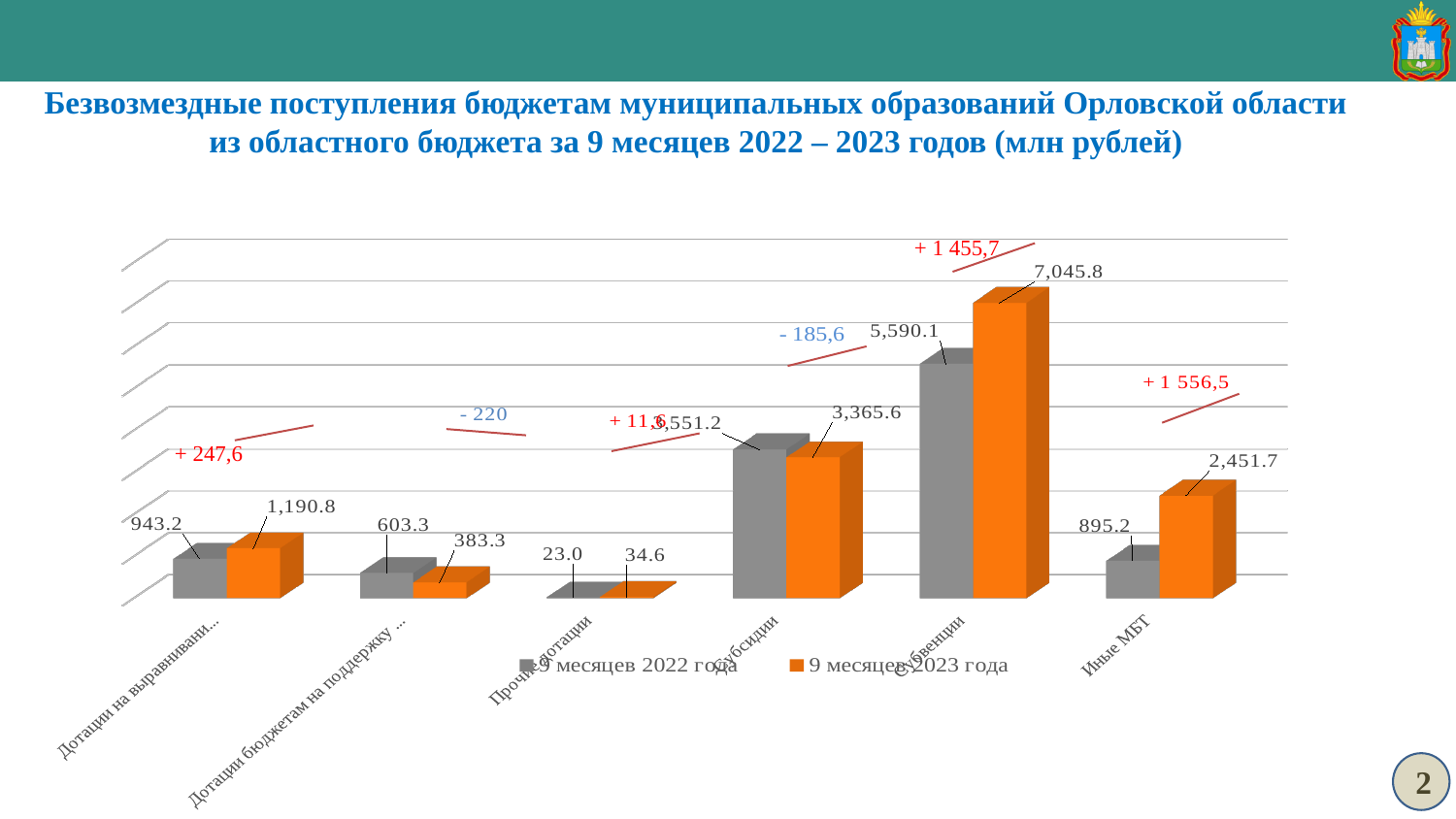
What is the value for Прочие дотации in the 9 месяцев 2023 года series? 34.6 What kind of chart is shown on the slide? Bar chart Which category has the highest value in the 9 месяцев 2023 года series? Субвенции How many categories are shown on the x axis of the chart? 6 What is the value for Иные МБТ in the 9 месяцев 2022 года series? 895.2 Which category has the lowest value in the 9 месяцев 2022 года series? Прочие дотации By how much does the 9 месяцев 2023 года value for Субвенции exceed the 9 месяцев 2022 года value? 1,455.7 For Субсидии, which series has the larger value: 9 месяцев 2022 года or 9 месяцев 2023 года? 9 месяцев 2022 года How many series does the legend list? 2 What is the value for Субвенции in the 9 месяцев 2023 года series? 7,045.8 By how much does the 9 месяцев 2023 года value for Иные МБТ exceed the 9 месяцев 2022 года value? 1,556.5 What is the value for Субсидии in the 9 месяцев 2022 года series? 3,551.2